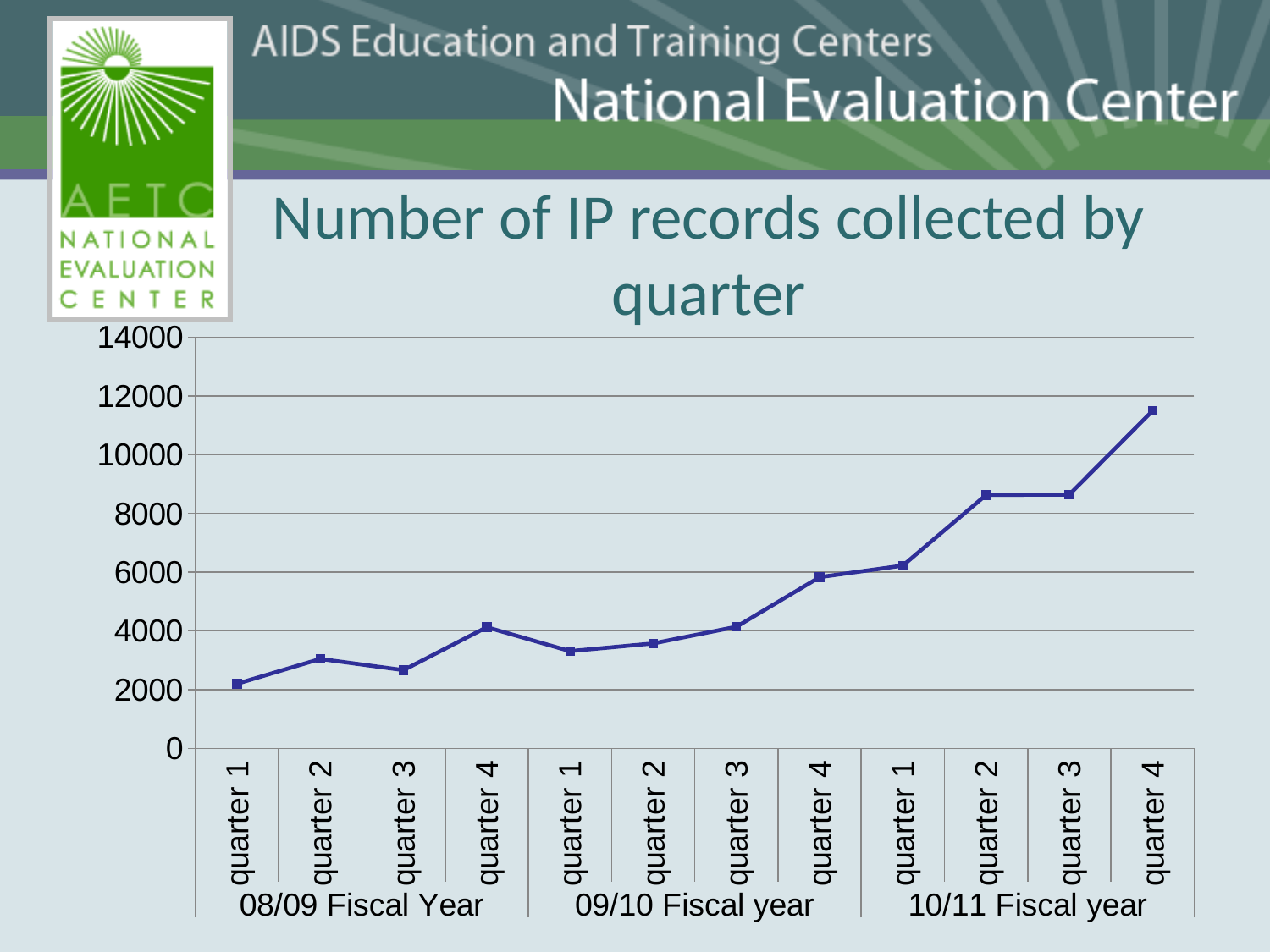
Overall, do the number of IP records collected rise or fall from the first quarter of 08/09 to the last quarter of 10/11? rise Is the value for quarter 4 of 10/11 Fiscal year greater or less than 10000? greater How many fiscal years are shown along the x axis? 3 What kind of chart is shown on the slide? line chart Is the value for quarter 1 of 08/09 Fiscal Year greater or less than 4000? less Is the value for quarter 4 of 09/10 Fiscal year greater or less than 4000? greater How many quarterly data points are plotted on the chart? 12 Which is larger: the value for quarter 2 or quarter 3 of 08/09 Fiscal Year? quarter 2 What is the title of the chart? Number of IP records collected by quarter Which quarter has the highest number of IP records collected? quarter 4 of 10/11 Fiscal year Which quarter has the lowest number of IP records collected? quarter 1 of 08/09 Fiscal Year